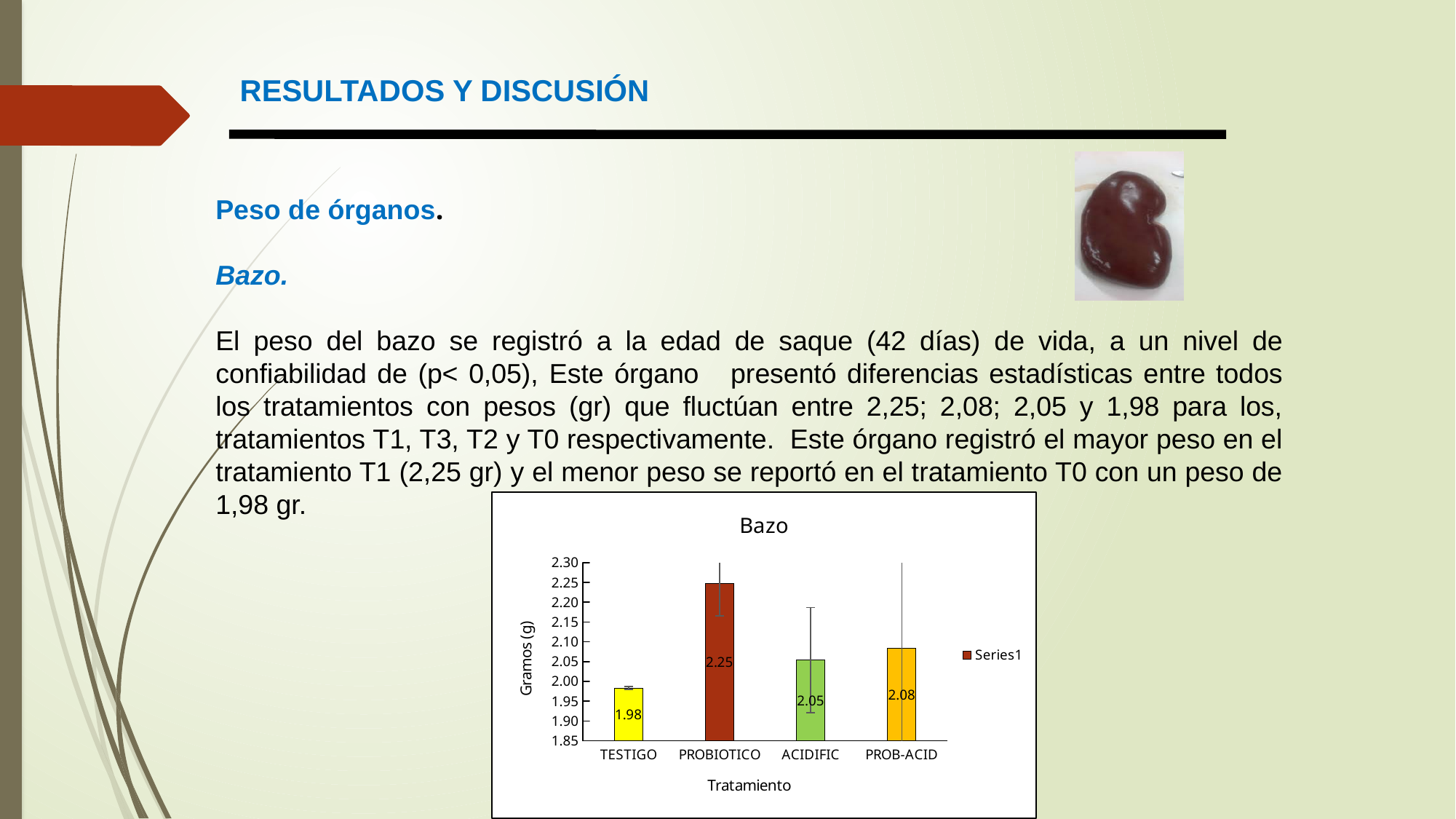
What is the value for ACIDIFIC in the Bazo chart? 2.05 What is the difference between the PROBIOTICO and TESTIGO values in the Bazo chart? 0.27 What type of chart is the Bazo chart? bar chart What is the value for PROB-ACID in the Bazo chart? 2.08 What is the y-axis label of the Bazo chart? Gramos (g) What is the value for TESTIGO in the Bazo chart? 1.98 Is the value for PROBIOTICO in the Bazo chart greater or less than 2.20? greater What is the value for PROBIOTICO in the Bazo chart? 2.25 Which treatment has the lowest value in the Bazo chart? TESTIGO How many treatments are shown on the x axis of the Bazo chart? 4 Which is larger in the Bazo chart, the value for ACIDIFIC or PROB-ACID? PROB-ACID Which treatment has the highest value in the Bazo chart? PROBIOTICO